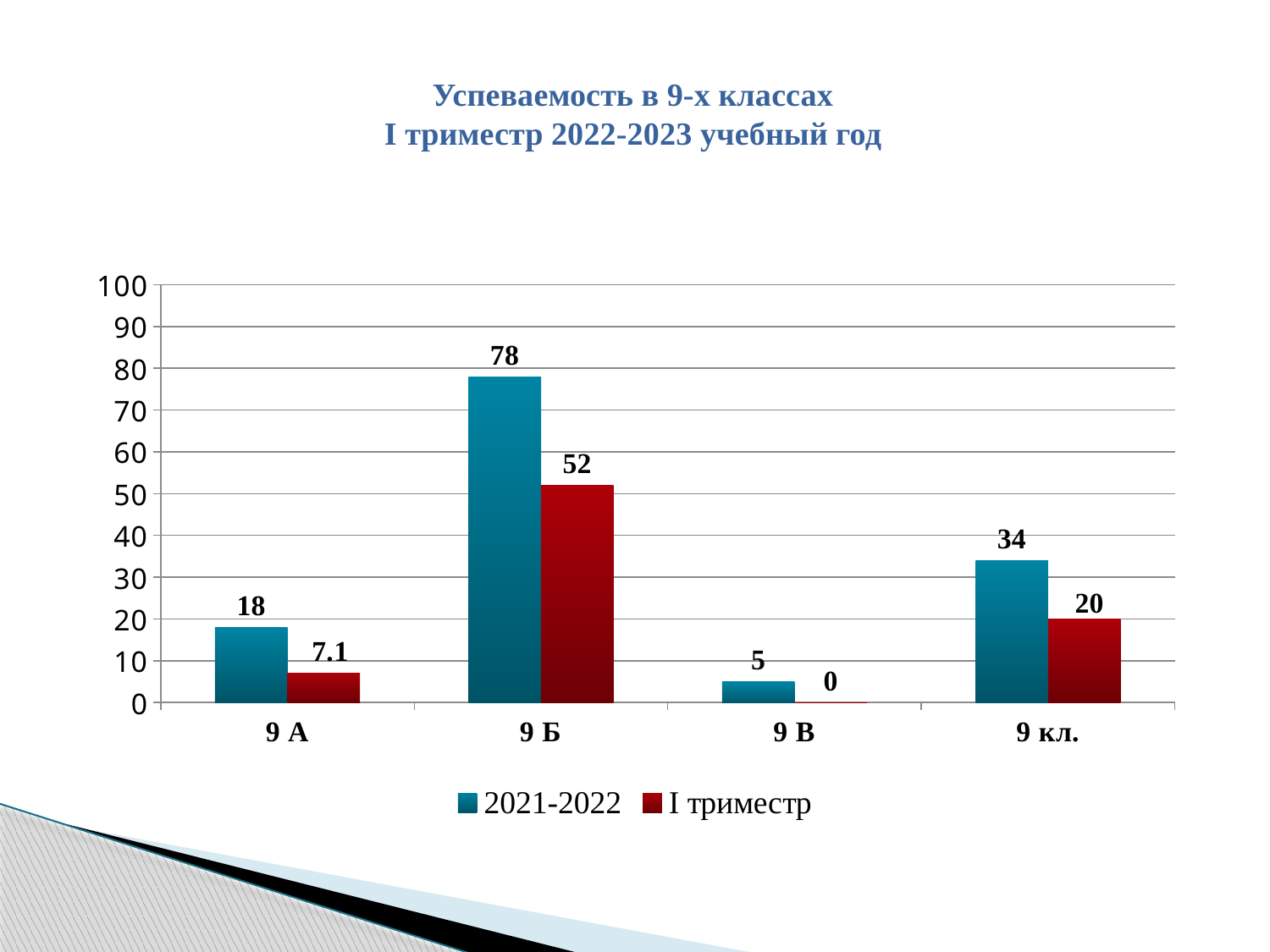
What is the title of the slide? Успеваемость в 9-х классах I триместр 2022-2023 учебный год What is the value for 9 Б in the 2021-2022 series? 78 Which category has the lowest value in the I триместр series? 9 В What is the value for 9 А in the I триместр series? 7.1 What is the value for 9 кл. in the 2021-2022 series? 34 How many categories are shown on the x axis? 4 What is the value for 9 В in the I триместр series? 0 What is the difference between the 2021-2022 and I триместр values for 9 Б? 26 Which category has the highest value in the 2021-2022 series? 9 Б Which is larger for 9 кл.: the 2021-2022 value or the I триместр value? 2021-2022 What kind of chart is shown on the slide? bar chart How many series does the legend list? 2